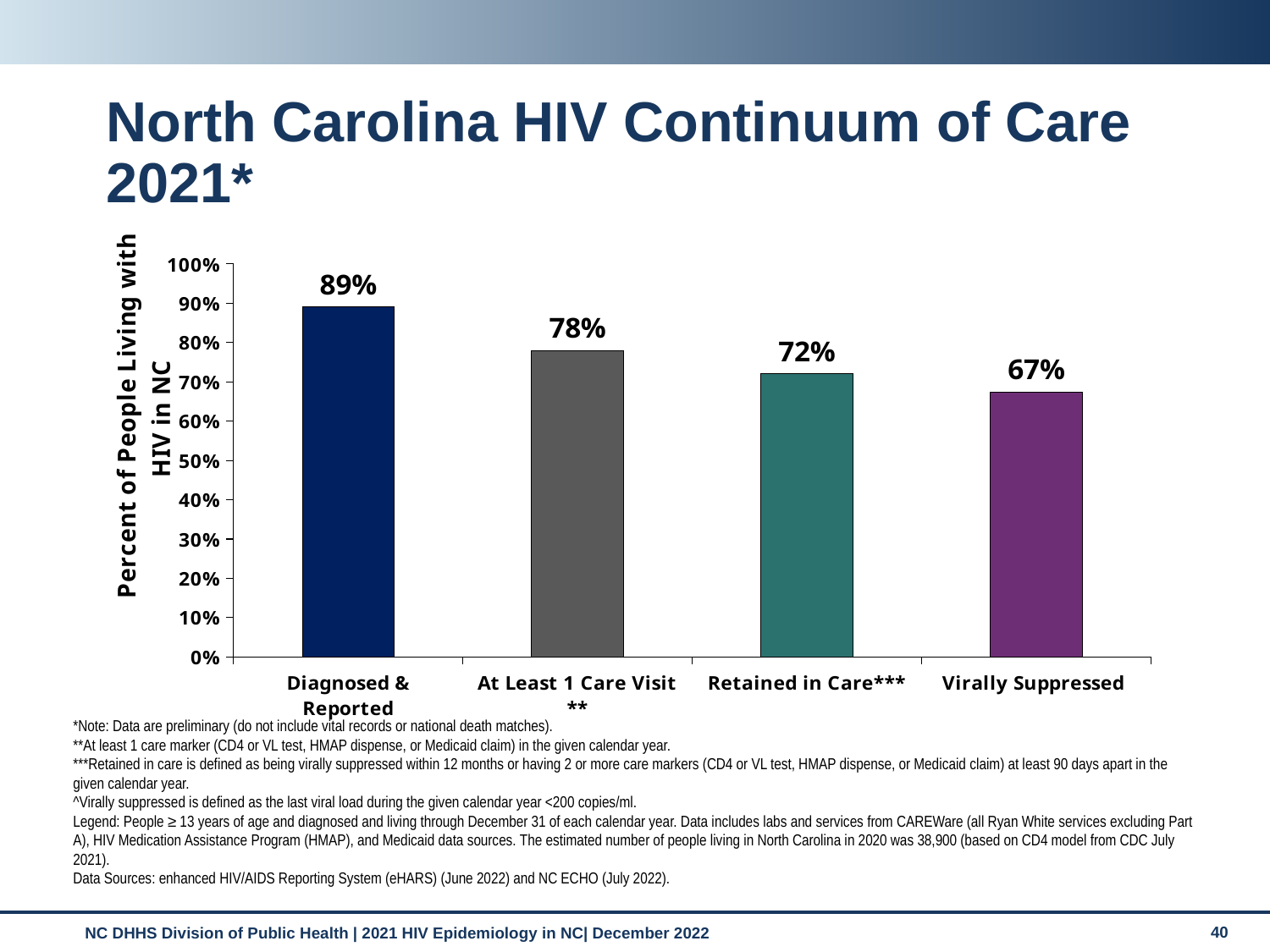
What is the value for Retained in Care? 72% Which category has the lowest value? Virally Suppressed What is the difference between the Diagnosed & Reported value and the Virally Suppressed value? 22% What percentage of people living with HIV in NC were Virally Suppressed? 67% What is the value for At Least 1 Care Visit? 78% What kind of chart is shown on the slide? Bar chart Which category has the highest value? Diagnosed & Reported How many categories are shown on the x axis? 4 What percentage of people living with HIV in NC were Diagnosed & Reported? 89% What is the difference between At Least 1 Care Visit and Retained in Care? 6% Do the values rise or fall moving from left to right along the x axis? Fall Which is larger, the value for Retained in Care or the value for Virally Suppressed? Retained in Care